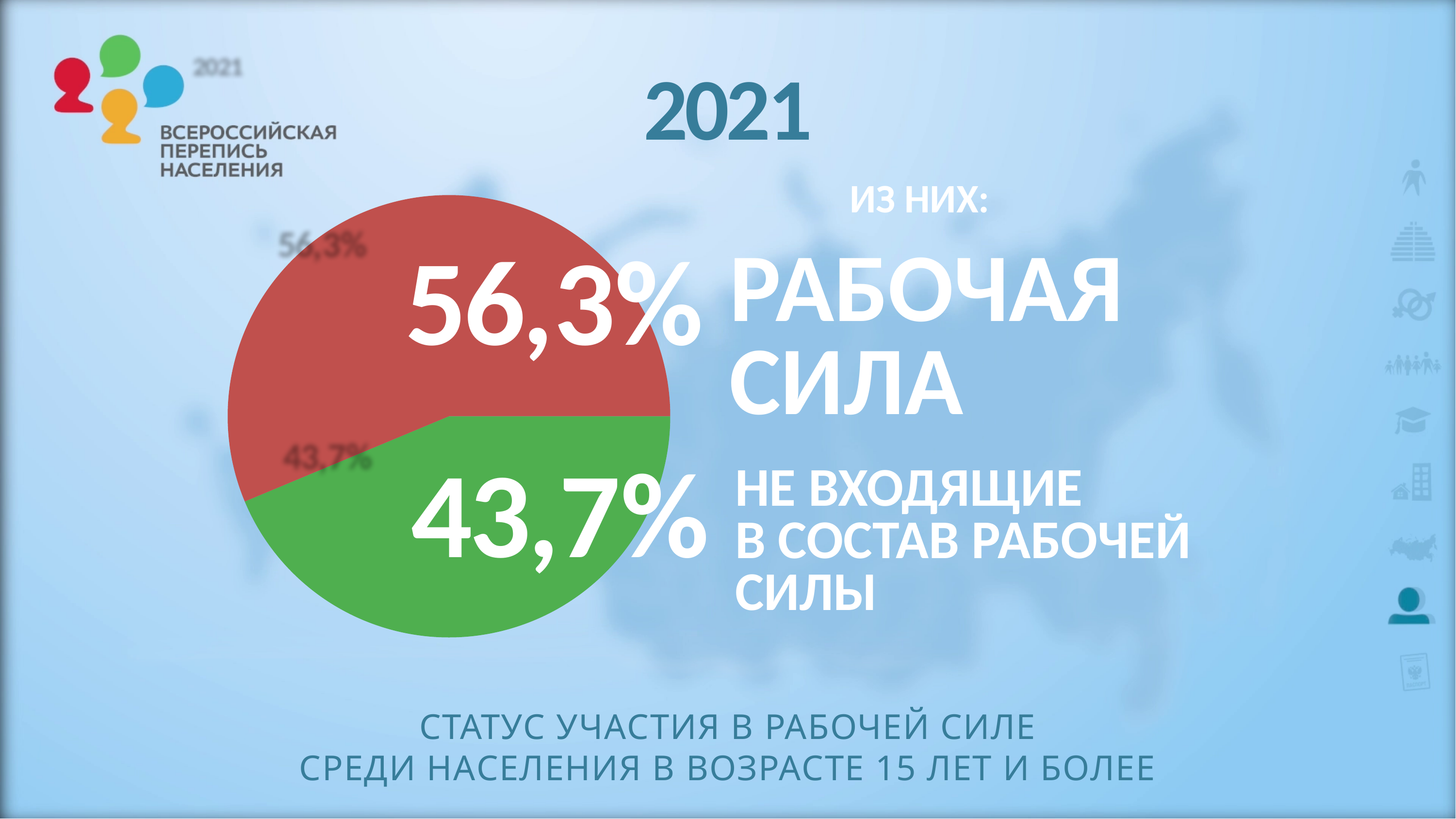
What share of the pie chart is labelled "Рабочая сила"? 56,3% Which slice of the pie chart is the largest? Рабочая сила What is the difference in percentage points between the "Рабочая сила" slice and the "Не входящие в состав рабочей силы" slice? 12,6 What colour is the "Не входящие в состав рабочей силы" slice of the pie chart? Green Which is larger: the share for "Рабочая сила" or the share for "Не входящие в состав рабочей силы"? Рабочая сила What colour is the "Рабочая сила" slice of the pie chart? Red Is the share for "Не входящие в состав рабочей силы" greater or less than 50%? less What type of chart is shown on the slide? Pie chart What share of the pie chart is labelled "Не входящие в состав рабочей силы"? 43,7% Which slice of the pie chart is the smallest? Не входящие в состав рабочей силы Is the share for "Рабочая сила" greater or less than 50%? greater How many slices does the pie chart have? 2